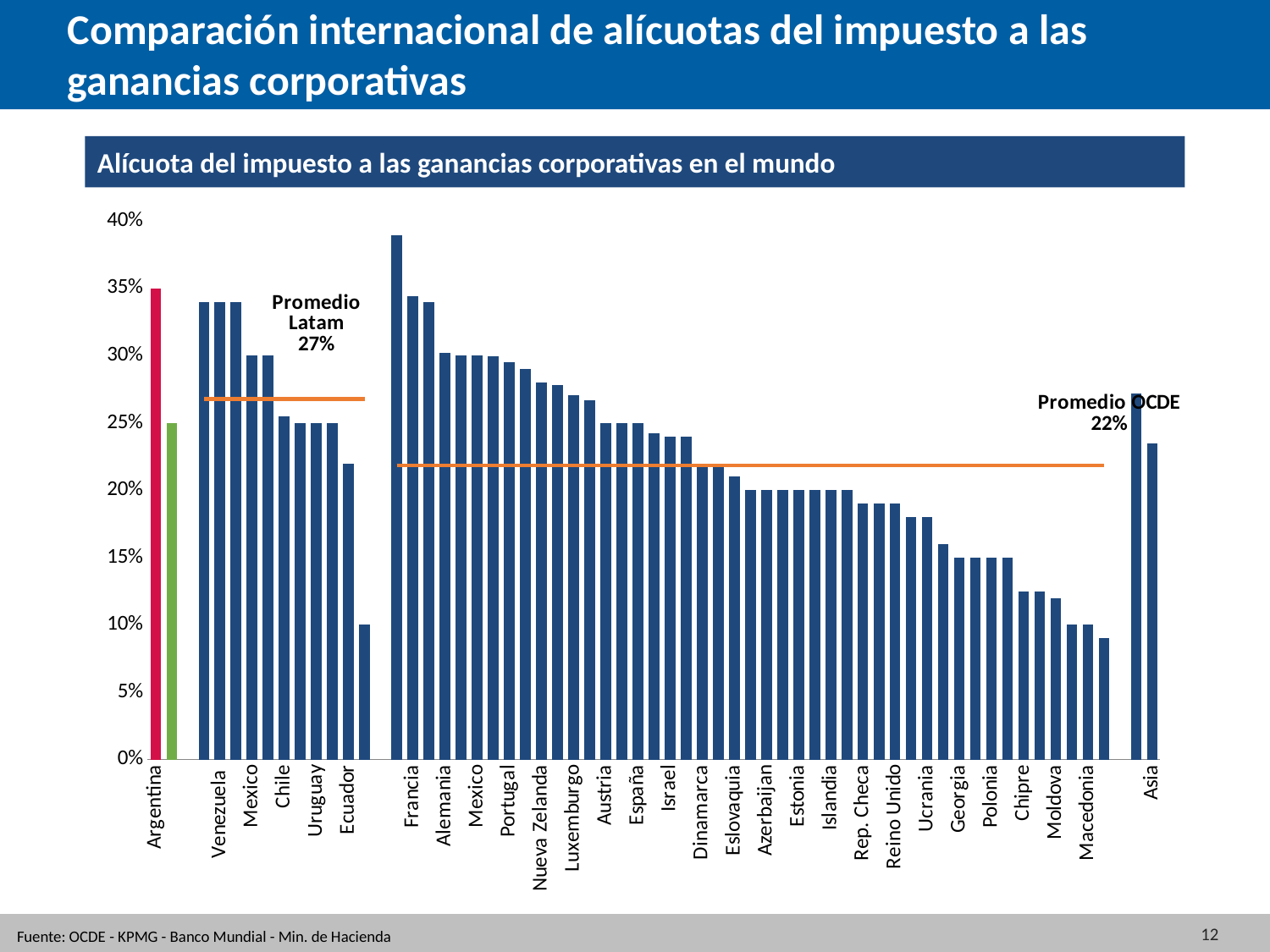
Is the value for Venezuela greater or less than 30%? greater Which has the lower value, Moldova or Israel? Moldova Which has the higher value, Alemania or Reino Unido? Alemania What value is printed for Promedio OCDE? 22% Which has the higher value, Georgia or Luxemburgo? Luxemburgo Is the value for Macedonia greater or less than 15%? less What kind of chart is shown on the slide? bar chart What is the title of the chart? Alícuota del impuesto a las ganancias corporativas en el mundo Is the value for Francia greater or less than 30%? greater What value is printed for Promedio Latam? 27%